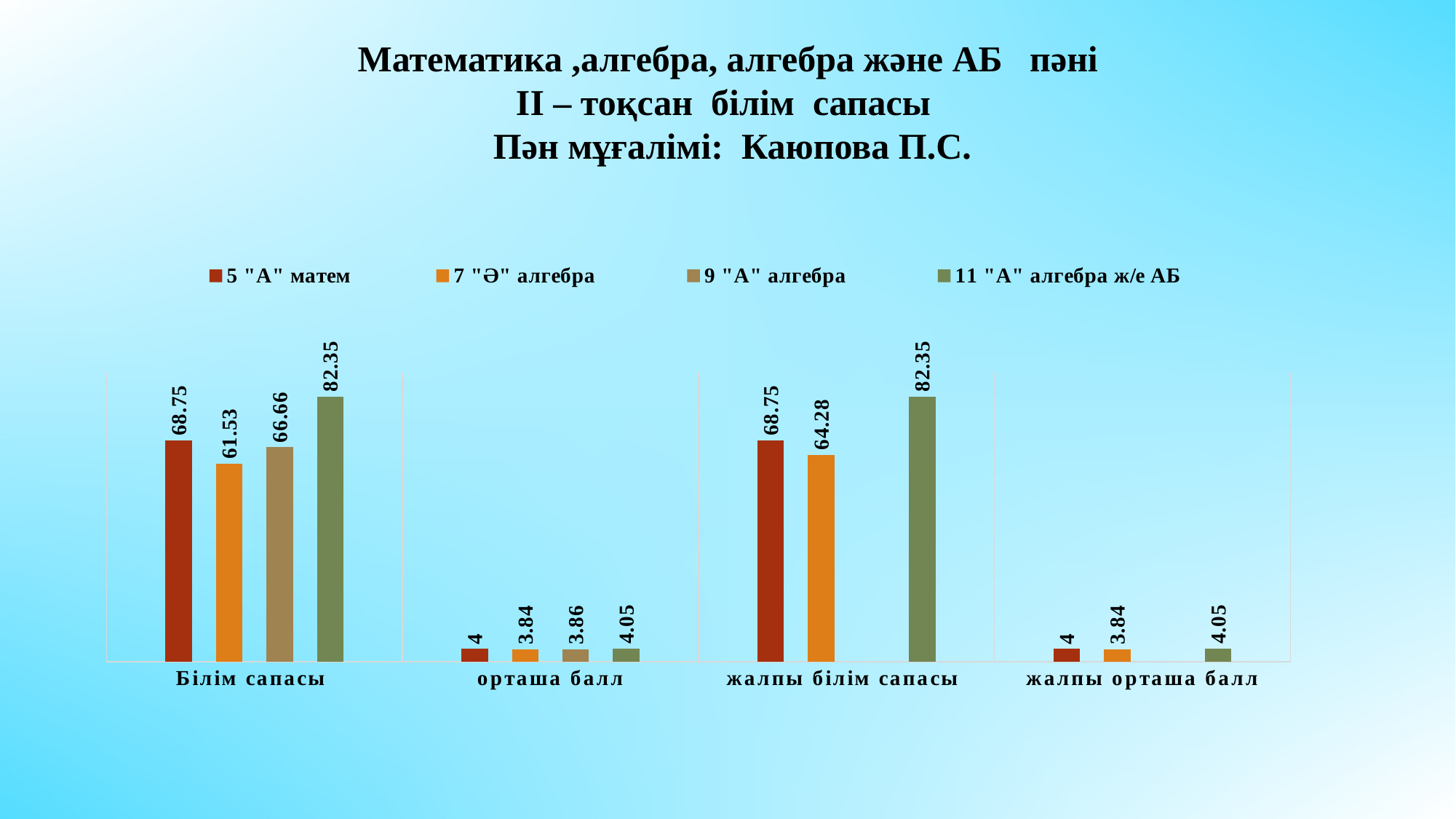
Which series has the highest value in the Білім сапасы category? 11 "А" алгебра ж/е АБ What kind of chart is shown on the slide? Bar chart What is the value for 5 "А" матем in the Білім сапасы category? 68.75 What is the value for 7 "Ә" алгебра in the жалпы білім сапасы category? 64.28 What is the difference between the 11 "А" алгебра ж/е АБ value and the 5 "А" матем value in the Білім сапасы category? 13.6 What is the value for 7 "Ә" алгебра in the Білім сапасы category? 61.53 What is the value for 9 "А" алгебра in the орташа балл category? 3.86 Which series is shown in orange in the legend? 7 "Ә" алгебра How many series does the legend list? 4 How many categories are shown on the x axis? 4 In the орташа балл category, which is larger: the value for 5 "А" матем or the value for 7 "Ә" алгебра? 5 "А" матем Which series has the lowest value in the Білім сапасы category? 7 "Ә" алгебра